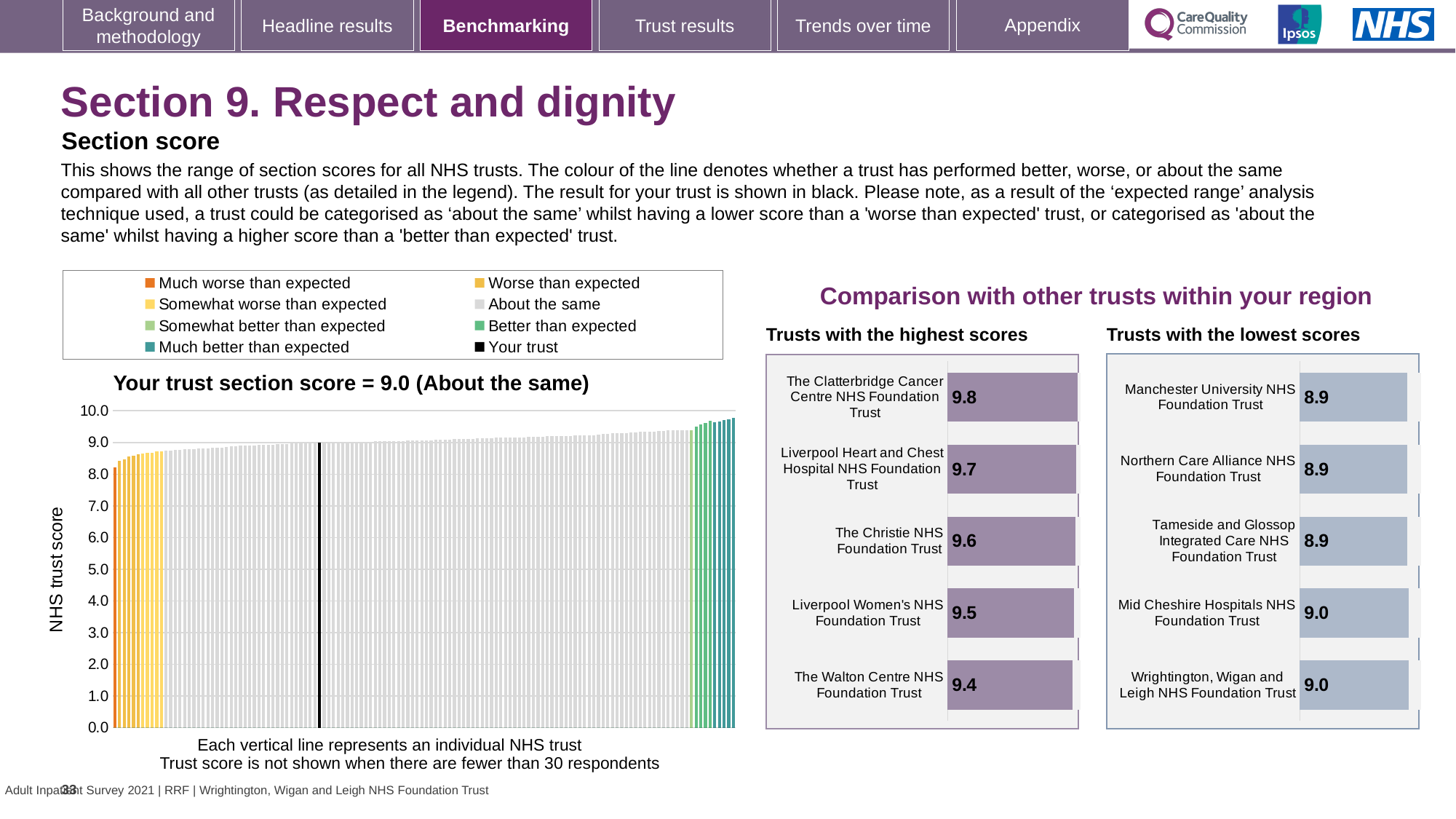
In the 'Your trust section score' chart on the left, do the trust scores rise or fall from left to right? Rise In the 'Trusts with the highest scores' chart, which trust has the highest score? The Clatterbridge Cancer Centre NHS Foundation Trust In the 'Trusts with the highest scores' chart, what is the score for The Christie NHS Foundation Trust? 9.6 In the 'Your trust section score' chart on the left, is the value of the leftmost (lowest) bar greater or less than 8.0? greater How many entries does the legend above the 'Your trust section score' chart list? 8 In the 'Your trust section score' chart on the left, what is the section score for your trust? 9.0 In the 'Trusts with the highest scores' chart, what is the difference between the scores of The Clatterbridge Cancer Centre NHS Foundation Trust and The Walton Centre NHS Foundation Trust? 0.4 What kind of chart is the 'Your trust section score' chart on the left? Bar chart In the 'Trusts with the lowest scores' chart, what is the difference between the scores of Wrightington, Wigan and Leigh NHS Foundation Trust and Northern Care Alliance NHS Foundation Trust? 0.1 In the 'Trusts with the lowest scores' chart, which is larger: the score for Mid Cheshire Hospitals NHS Foundation Trust or the score for Manchester University NHS Foundation Trust? Mid Cheshire Hospitals NHS Foundation Trust In the 'Trusts with the highest scores' chart, how many trusts are shown? 5 In the 'Trusts with the lowest scores' chart, what is the score for Tameside and Glossop Integrated Care NHS Foundation Trust? 8.9